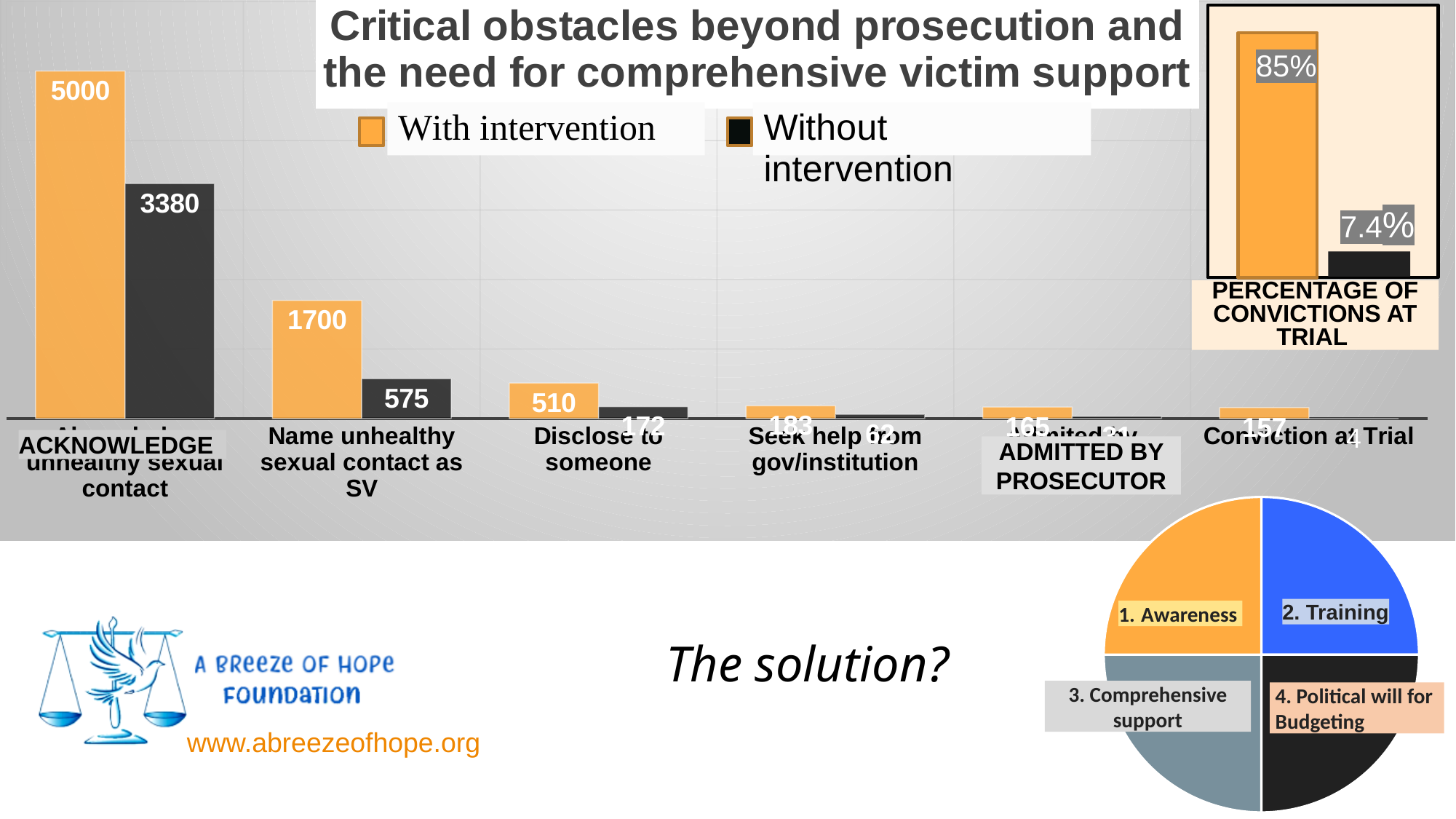
In the main bar chart, what is the difference between the 'With intervention' and 'Without intervention' values for 'Name unhealthy sexual contact as SV'? 1125 In the main bar chart, which category has the highest 'With intervention' value? Acknowledge unhealthy sexual contact How many slices does the pie chart at the bottom right of the slide have? 4 In the main bar chart, what is the difference between the 'With intervention' and 'Without intervention' values for 'Acknowledge unhealthy sexual contact'? 1620 In the main bar chart, what is the value for 'Without intervention' in the 'Name unhealthy sexual contact as SV' category? 575 In the main bar chart, do the 'With intervention' values rise or fall from left to right along the x axis? fall In the main bar chart, which is larger: the 'With intervention' value for 'Disclose to someone' or the 'Without intervention' value for 'Name unhealthy sexual contact as SV'? Without intervention for Name unhealthy sexual contact as SV In the main bar chart, what is the value for 'With intervention' in the 'Disclose to someone' category? 510 In the main bar chart, what is the value for 'With intervention' in the 'Name unhealthy sexual contact as SV' category? 1700 How many series does the legend of the main bar chart list? 2 In the main bar chart, what is the value for 'Without intervention' in the 'Acknowledge unhealthy sexual contact' category? 3380 In the small 'Percentage of convictions at trial' chart, what is the value for 'With intervention'? 85%